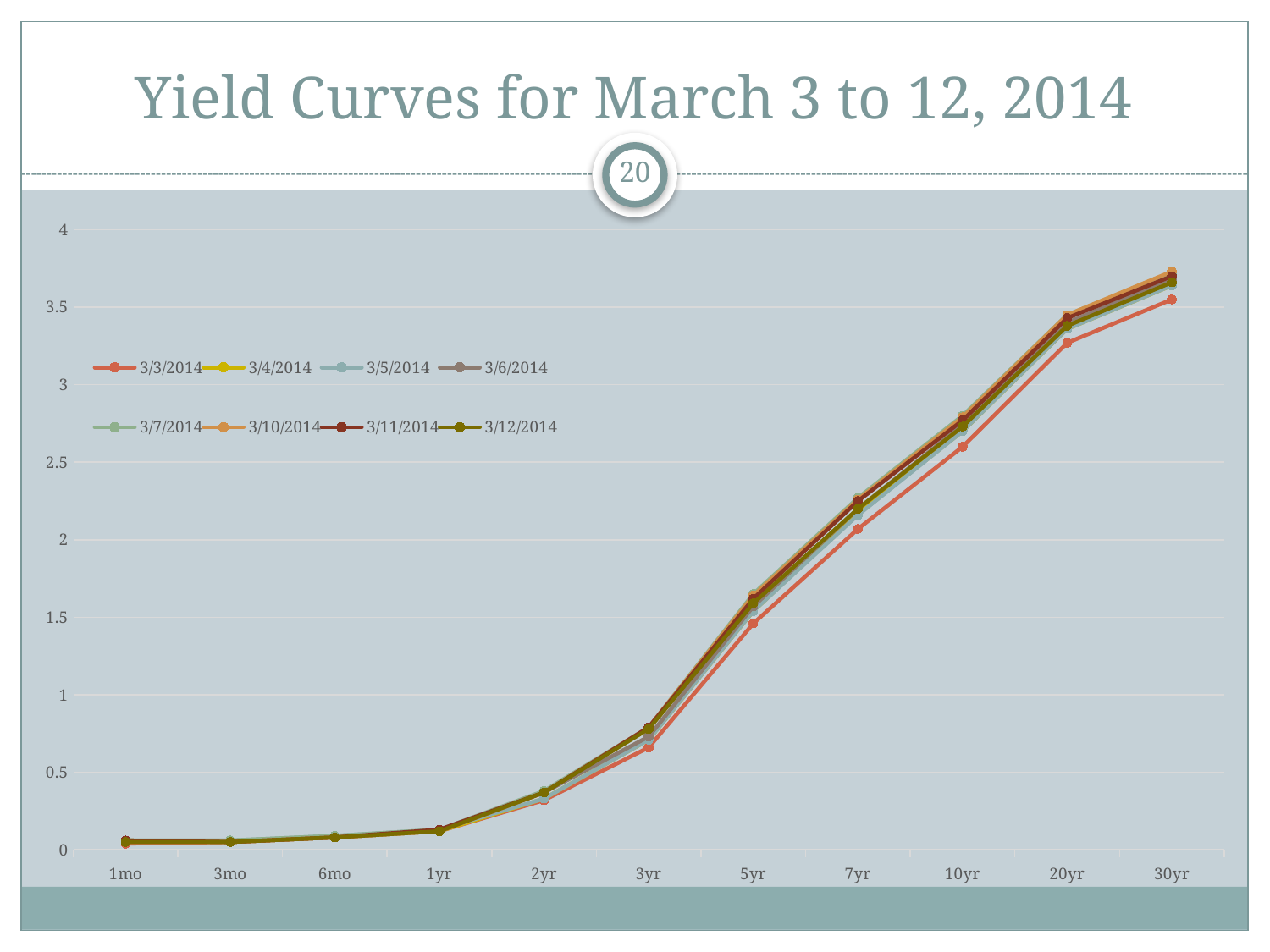
What kind of chart is shown on the slide? line chart Do the yield values rise or fall as maturity increases from 1mo to 30yr? rise How many maturity categories are shown on the x axis? 11 Which maturity has the highest yield for the 3/3/2014 series? 30yr How many series does the legend list? 8 Is the value for 3/11/2014 at 2yr greater or less than 0.5? less What is the title of the chart? Yield Curves for March 3 to 12, 2014 For the 3/3/2014 series, which is larger: the value at 20yr or the value at 30yr? 30yr Which series has the lowest value at the 10yr maturity? 3/3/2014 Which series has the lowest value at the 30yr maturity? 3/3/2014 Is the value for 3/3/2014 at 20yr greater or less than 3? greater Is the value for 3/3/2014 at 10yr greater or less than 3? less